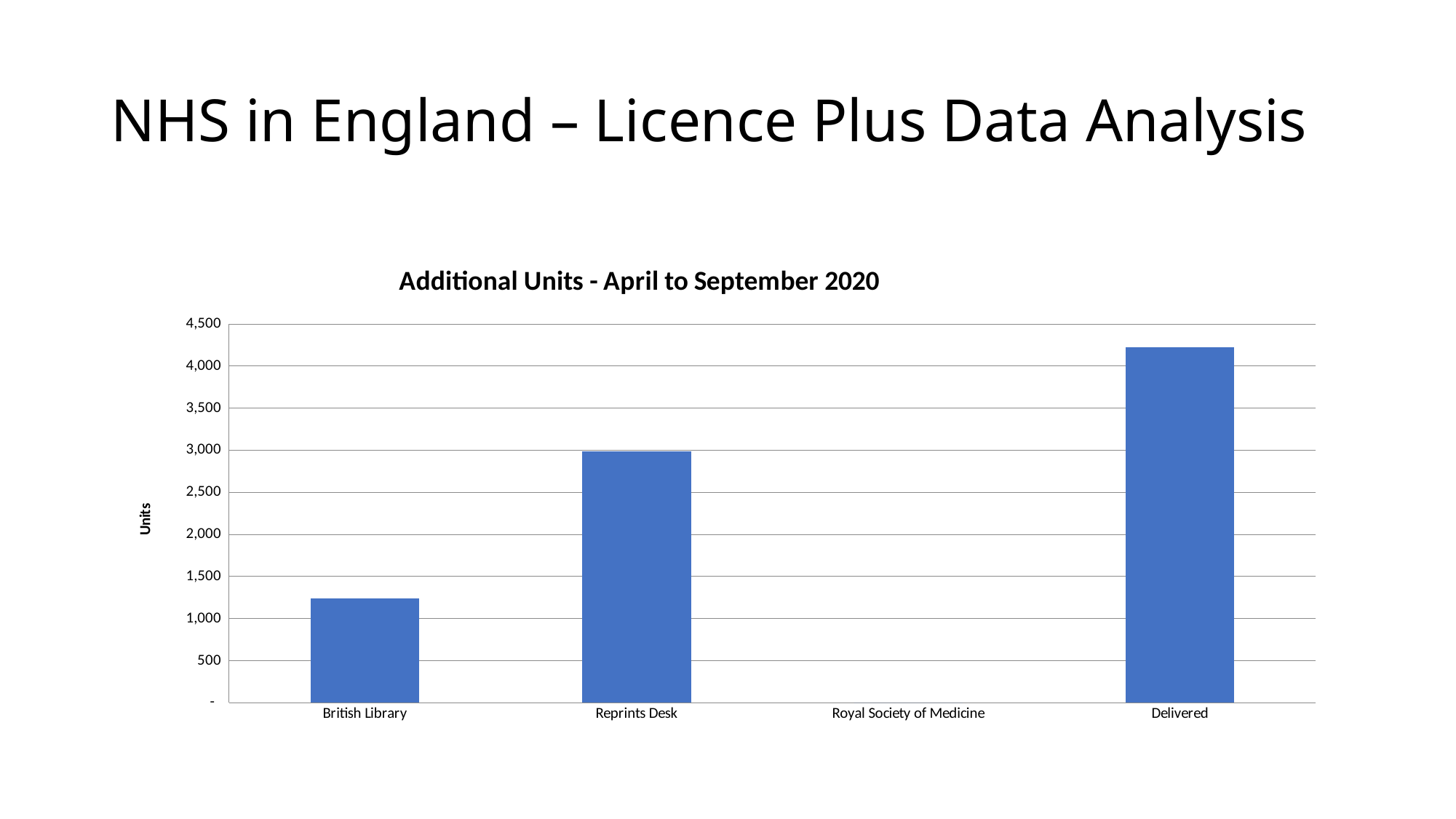
Is the value for British Library greater or less than 1,500? less Which has a larger value, Delivered or Reprints Desk? Delivered What is the title of the chart? Additional Units - April to September 2020 Is the value for Reprints Desk greater or less than 2,500? greater Is the value for British Library greater or less than 1,000? greater What kind of chart is shown on the slide? Bar chart Which has a larger value, Reprints Desk or British Library? Reprints Desk Which category has the lowest value in the chart? Royal Society of Medicine What is the label on the vertical axis of the chart? Units How many categories are shown on the x axis of the chart? 4 Which category has the highest value in the chart? Delivered